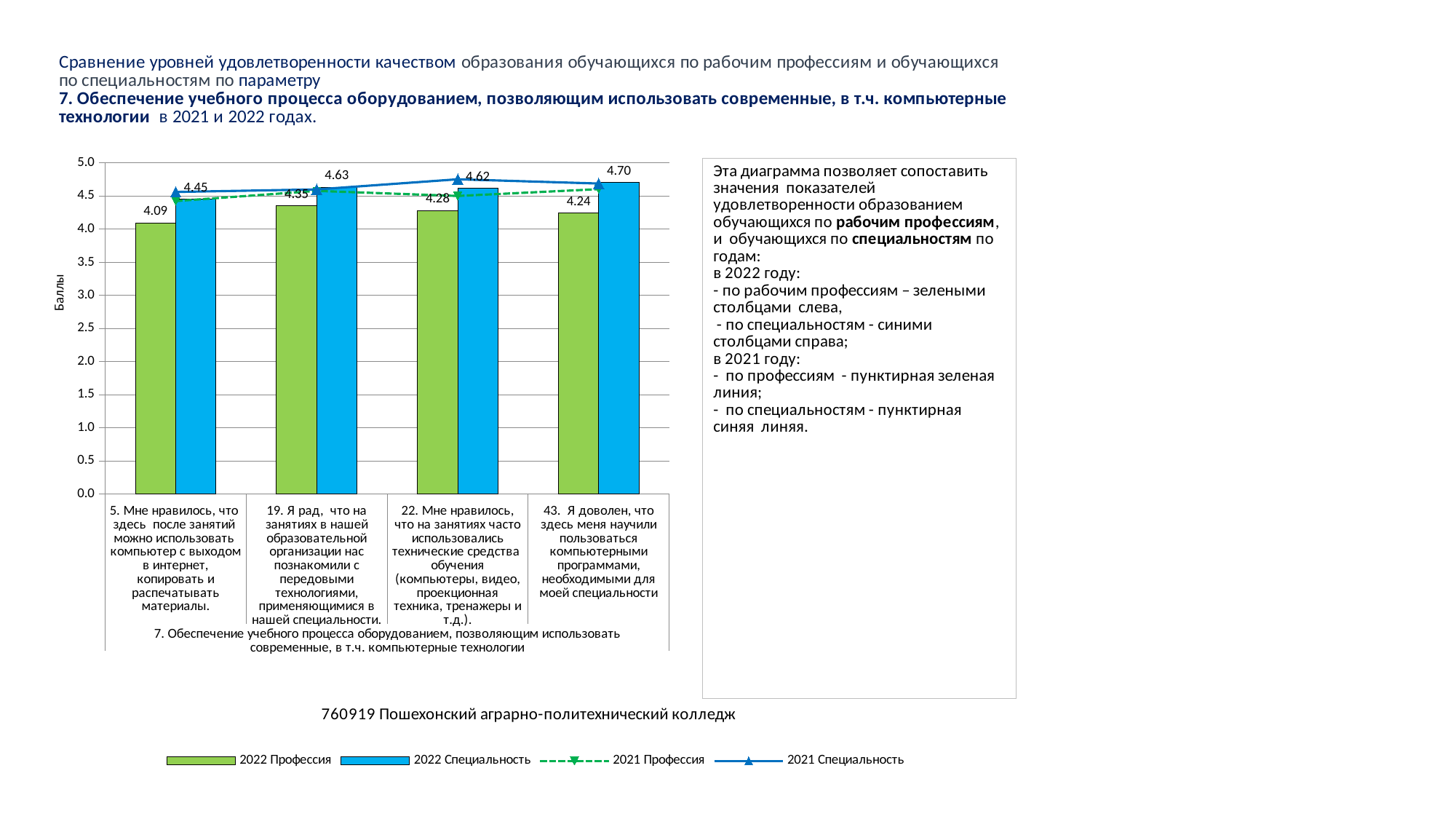
How many categories are shown on the x axis of the chart? 4 Is the 2021 Специальность line value for category 19 greater or less than 4.0? greater What is the value of the 2022 Специальность bar for category 43 ("Я доволен, что здесь меня научили пользоваться компьютерными программами...")? 4.70 Which category has the highest 2022 Профессия bar? 19. Я рад, что на занятиях в нашей образовательной организации нас познакомили с передовыми технологиями, применяющимися в нашей специальности. What is the difference between the 2022 Специальность and 2022 Профессия bars for category 43? 0.46 What kind of chart is shown on the slide? Combined bar and line chart What is the label of the vertical axis of the chart? Баллы Which category has the lowest 2022 Специальность bar? 5. Мне нравилось, что здесь после занятий можно использовать компьютер с выходом в интернет, копировать и распечатывать материалы. For category 22 ("Мне нравилось, что на занятиях часто использовались технические средства обучения..."), which is larger: the 2022 Профессия bar or the 2022 Специальность bar? 2022 Специальность How many series does the chart legend list? 4 What is the value of the 2022 Профессия bar for category 5 ("Мне нравилось, что здесь после занятий можно использовать компьютер...")? 4.09 What is the value of the 2022 Специальность bar for category 19 ("Я рад, что на занятиях в нашей образовательной организации нас познакомили с передовыми технологиями...")? 4.63